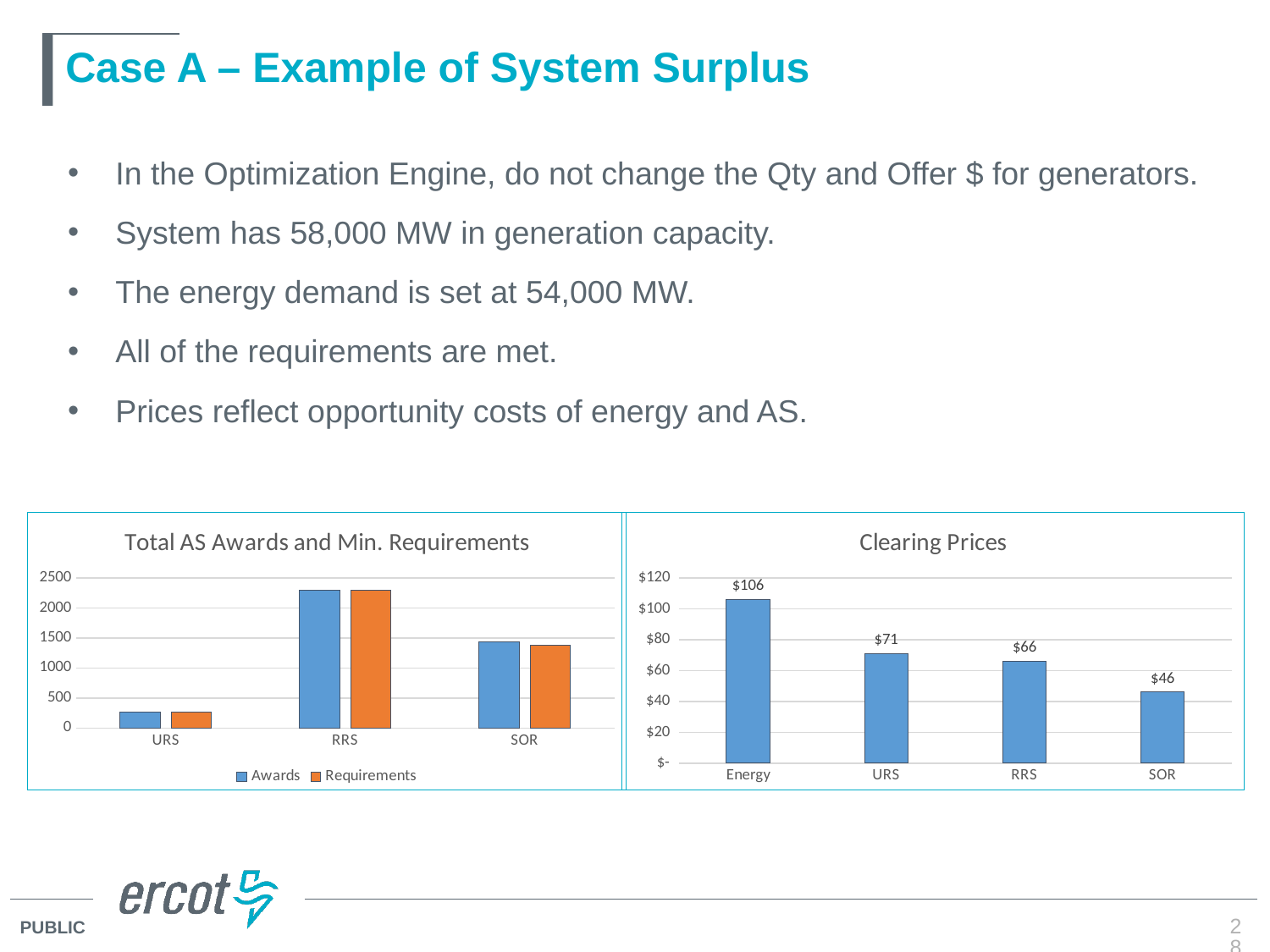
In the Clearing Prices chart, what is the clearing price for SOR? $46 In the Total AS Awards and Min. Requirements chart, which category has the highest Awards value? RRS In the Clearing Prices chart, which category has the highest clearing price? Energy In the Clearing Prices chart, which is larger, the URS price or the RRS price? URS In the Clearing Prices chart, what is the clearing price for Energy? $106 How many categories are shown in the Clearing Prices chart? 4 In the Total AS Awards and Min. Requirements chart, is the Awards value for RRS greater or less than 2000? greater How many series does the legend of the Total AS Awards and Min. Requirements chart list? 2 In the Clearing Prices chart, which category has the lowest clearing price? SOR In the Clearing Prices chart, what is the difference between the Energy price and the SOR price? $60 What type of chart is the Clearing Prices chart? Bar chart In the Total AS Awards and Min. Requirements chart, is the Requirements value for URS greater or less than 500? less